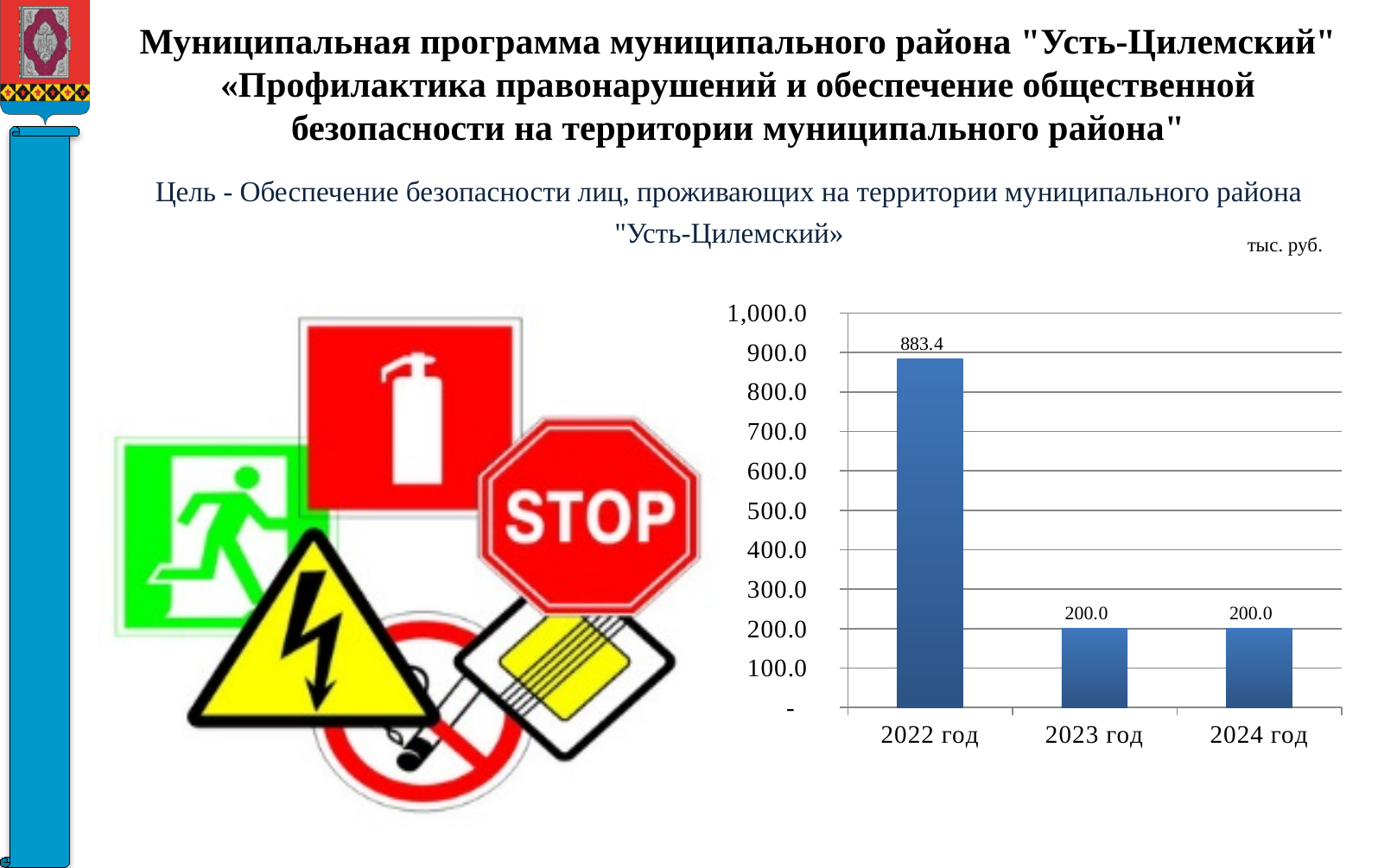
What unit is indicated above the chart? тыс. руб. What is the difference between the values for 2022 год and 2023 год? 683.4 Is the value for 2022 год greater or less than 800.0? greater What kind of chart is shown on the slide? bar chart What is the value for 2023 год? 200.0 What is the value for 2022 год? 883.4 Do the values rise or fall from 2022 год to 2023 год? fall Which is larger, the value for 2022 год or the value for 2024 год? 2022 год How many years are shown on the x axis? 3 What is the value for 2024 год? 200.0 Which year has the highest value? 2022 год Is the value for 2023 год greater or less than 500.0? less